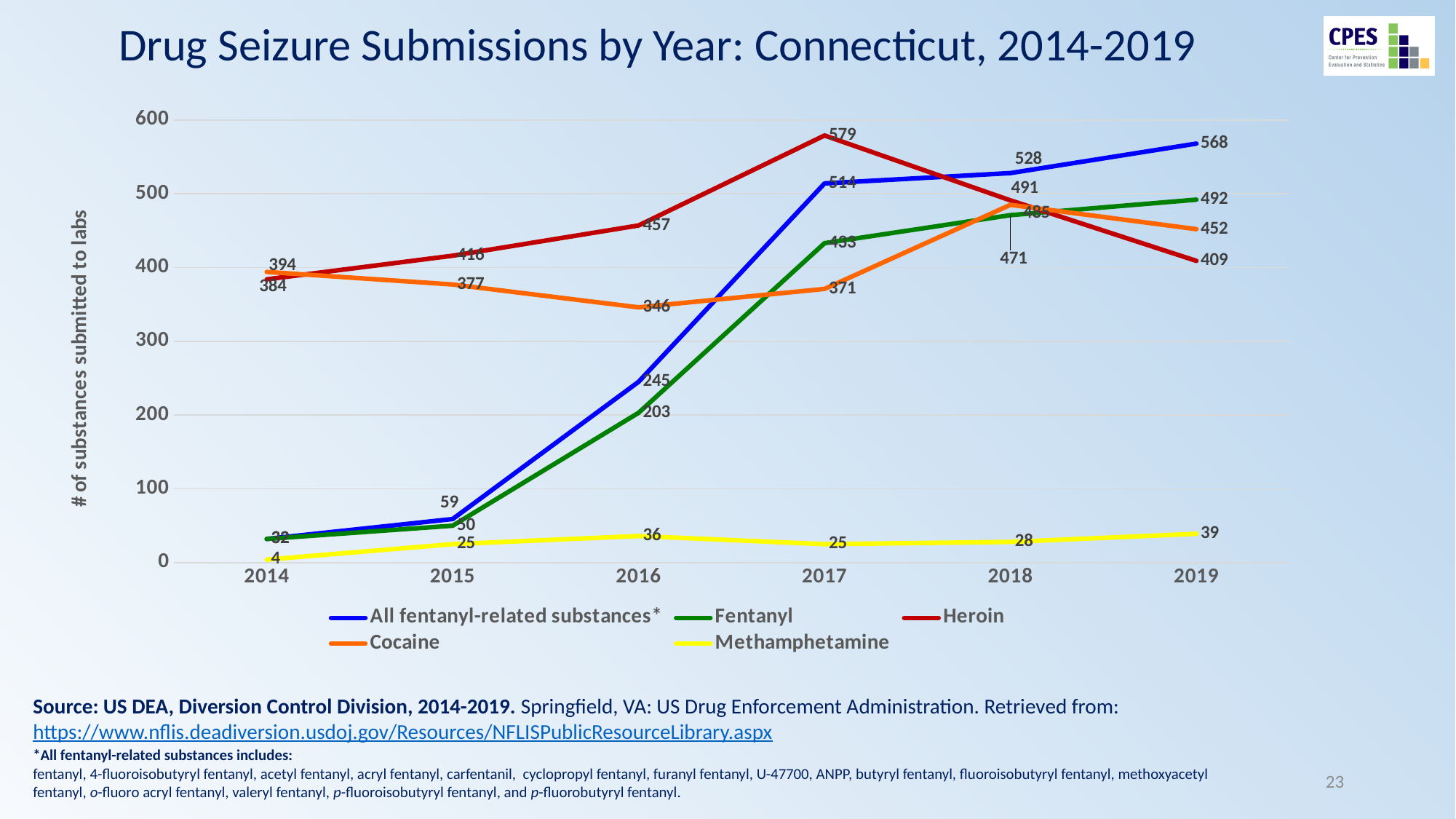
How many years are plotted along the x axis? 6 In which year did heroin submissions peak? 2017 What was the cocaine value in 2016? 346 What was the value for All fentanyl-related substances* in 2019? 568 What was the number of heroin submissions in 2017? 579 Which series had the lowest value in 2019? Methamphetamine What was the methamphetamine value in 2014? 4 Do the values for All fentanyl-related substances* rise or fall from 2014 to 2019? rise What is the difference between heroin submissions in 2017 and in 2019? 170 What type of chart is shown on the slide? line chart How many series does the legend list? 5 In 2019, which was larger: All fentanyl-related substances* or Heroin? All fentanyl-related substances*